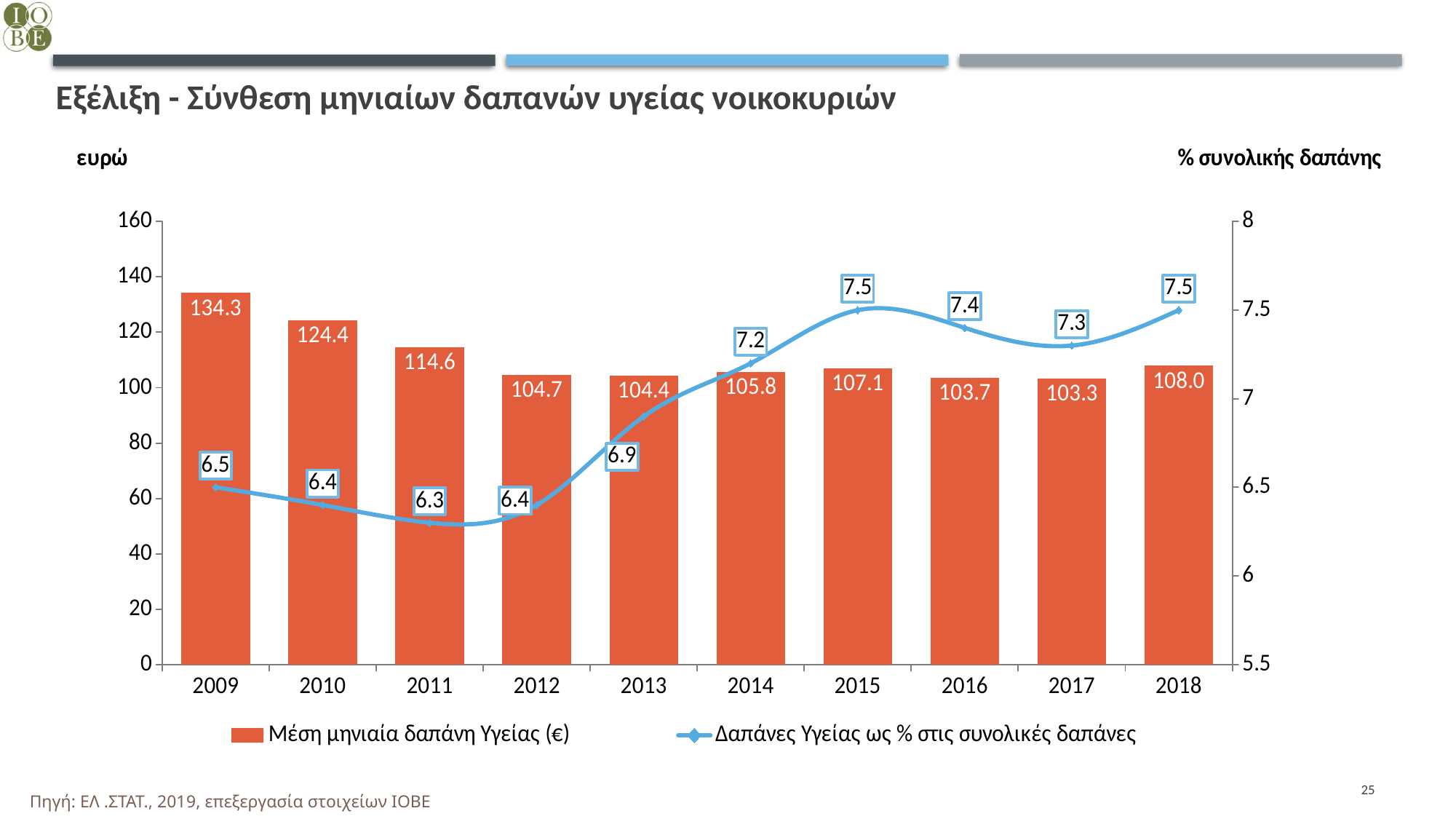
In which year is the health expenditure as % of total expenditure (line) lowest? 2011 Do the bar values (average monthly health expenditure) rise or fall from 2009 to 2012? Fall How many series does the legend list? 2 What is the difference between the average monthly health expenditure in 2009 and in 2018? 26.3 What kind of chart is shown on the slide? Combination bar and line chart How many years are shown on the x axis? 10 What is the value of the line series (Δαπάνες Υγείας ως % στις συνολικές δαπάνες) in 2018? 7.5 What is the value of health expenditure as % of total expenditure (Δαπάνες Υγείας ως % στις συνολικές δαπάνες) in 2013? 6.9 What is the average monthly health expenditure (Μέση μηνιαία δαπάνη Υγείας) for 2009? 134.3 In which year is the average monthly health expenditure (bars) highest? 2009 Which year has a larger average monthly health expenditure, 2015 or 2016? 2015 What is the legend label for the orange bars? Μέση μηνιαία δαπάνη Υγείας (€)